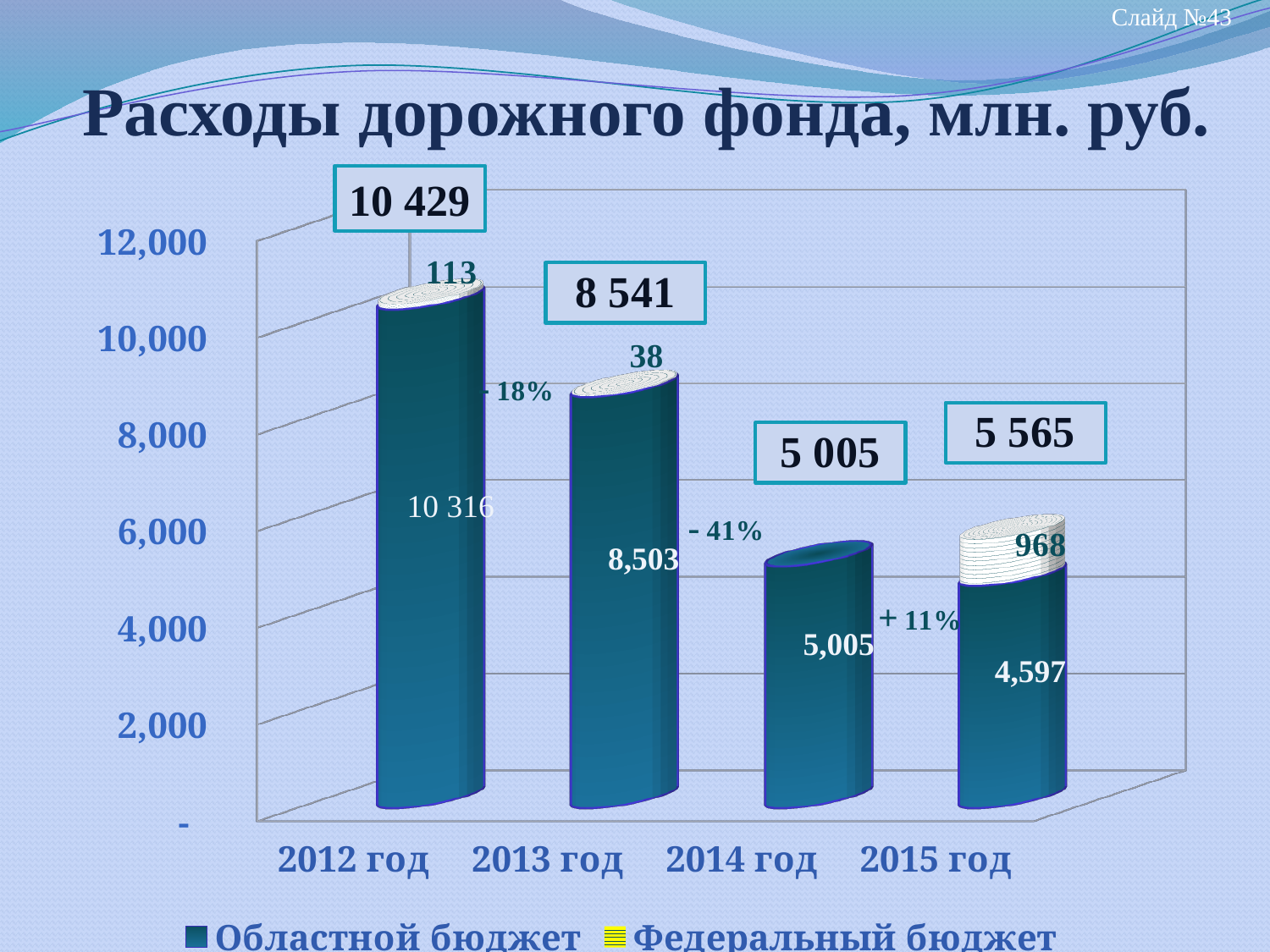
How many series does the legend list? 2 What is the value of Федеральный бюджет for 2015 год? 968 What kind of chart is shown on the slide? bar chart How many categories (years) are shown on the x axis? 4 Do the Областной бюджет values rise or fall from 2012 год to 2015 год? fall What is the title of the chart? Расходы дорожного фонда, млн. руб. What is the value of Областной бюджет for 2012 год? 10 316 What is the total shown above the bar for 2015 год? 5 565 What is the difference between the Областной бюджет values for 2013 год and 2014 год? 3,498 Which year has the lowest value for Областной бюджет? 2015 год What is the value of Областной бюджет for 2013 год? 8,503 Which year has the highest total expenditure? 2012 год